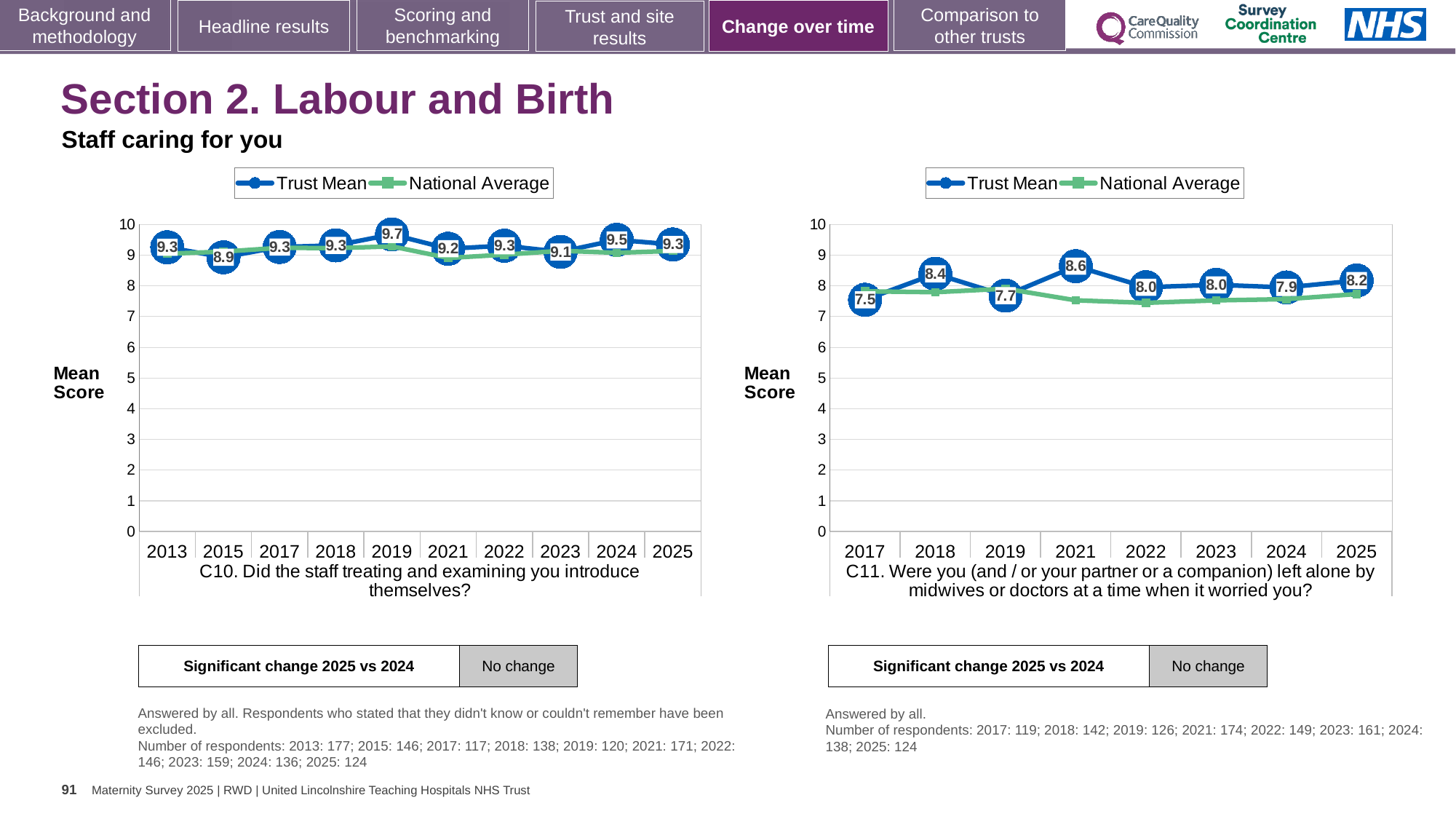
In the C10 chart (left), which year has the highest Trust Mean score? 2019 In the C11 chart (right), what is the difference between the Trust Mean scores for 2025 and 2024? 0.3 In the C10 chart (left), what is the difference between the Trust Mean scores for 2024 and 2023? 0.4 In the C11 chart (right), what is the Trust Mean score for 2021? 8.6 In the C10 chart (left), what is the Trust Mean score for 2015? 8.9 How many series does the legend of the C11 chart (right) list? 2 In the C10 chart (left), which year has the lowest Trust Mean score? 2015 In the C11 chart (right), which year has the lowest Trust Mean score? 2017 In the C10 chart (left), how many years are shown on the x axis? 10 In the C10 chart (left), what is the Trust Mean score for 2019? 9.7 In the C11 chart (right), is the National Average value for 2022 greater or less than 8? less In the C11 chart (right), is the Trust Mean score for 2018 or 2019 higher? 2018